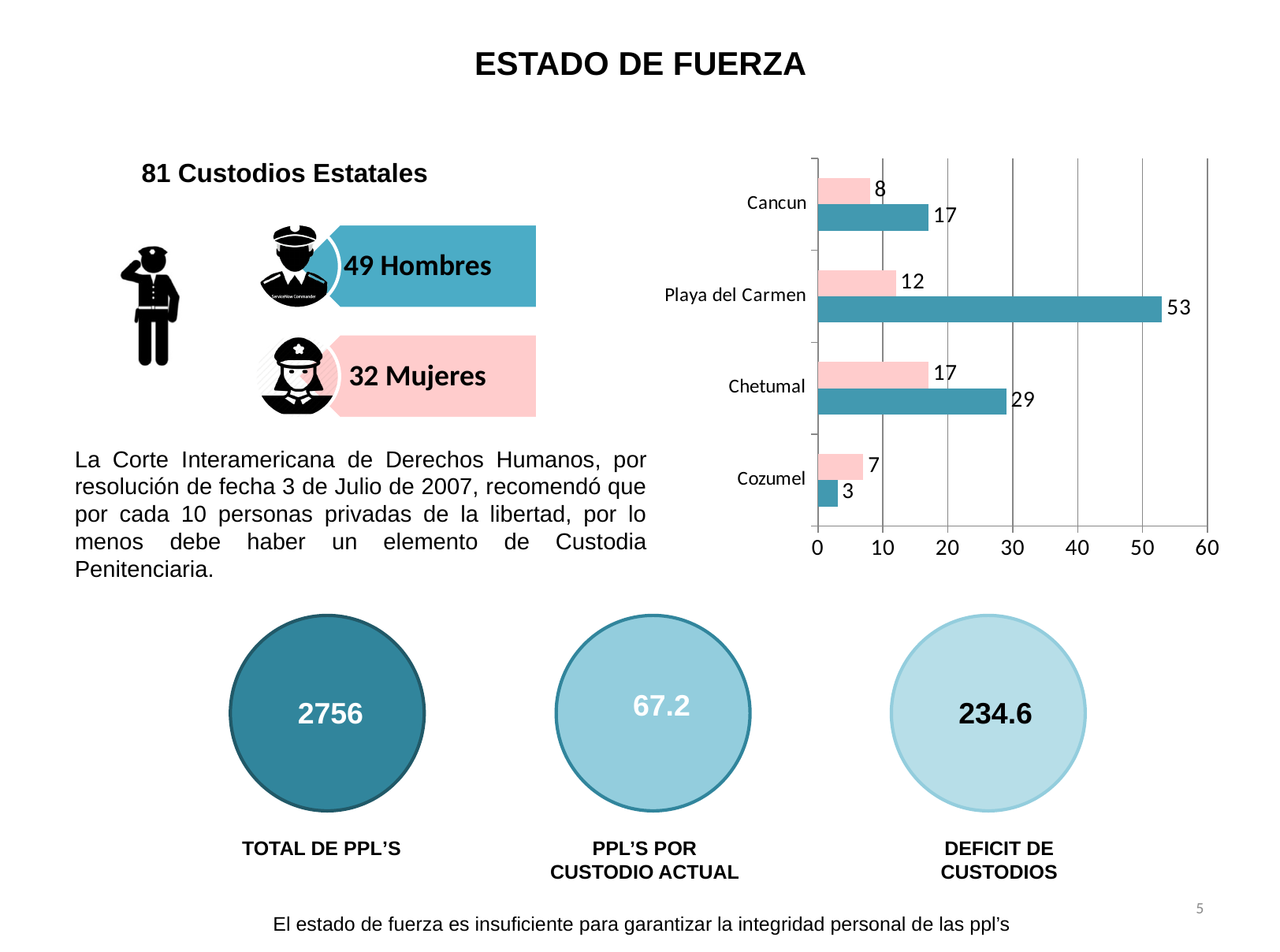
For Cozumel, which bar is larger, the pink one or the teal one? pink What kind of chart is shown on the right side of the slide? bar chart What is the value of the teal bar for Cozumel? 3 Is the teal bar for Playa del Carmen greater or less than 50? greater What is the value of the pink bar for Cancun? 8 What is the difference between the teal and pink bars for Playa del Carmen? 41 What is the difference between the teal bars for Chetumal and Cancun? 12 Which category has the highest teal bar? Playa del Carmen What is the value of the teal bar for Playa del Carmen? 53 Which category has the lowest pink bar? Cozumel What is the value of the pink bar for Chetumal? 17 How many categories does the bar chart show? 4